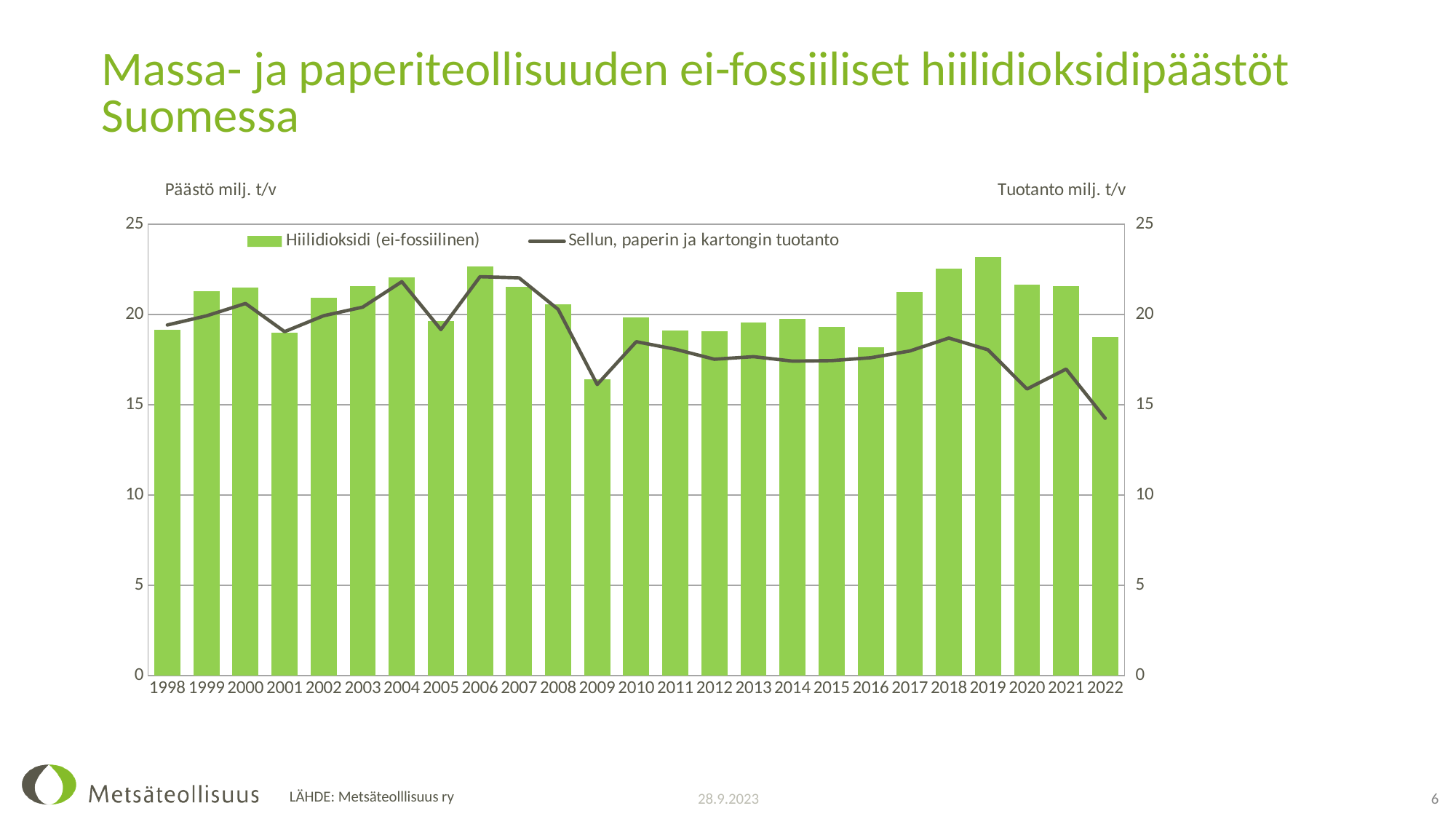
In which year does the Sellun, paperin ja kartongin tuotanto line reach its lowest point? 2022 What kind of chart is shown on the slide? Combined bar and line chart Is the Sellun, paperin ja kartongin tuotanto value for 2022 greater or less than 15? less Does the Sellun, paperin ja kartongin tuotanto line rise or fall from 2019 to 2022? fall Is the Hiilidioksidi (ei-fossiilinen) bar for 2006 taller or shorter than the bar for 2009? taller Is the Hiilidioksidi (ei-fossiilinen) value for 2019 greater or less than 20? greater How many series does the chart legend list? 2 Which year has the tallest bar for Hiilidioksidi (ei-fossiilinen)? 2019 Is the Hiilidioksidi (ei-fossiilinen) value for 2001 greater or less than 20? less Which year has the shortest bar for Hiilidioksidi (ei-fossiilinen)? 2009 How many years are shown on the x axis of the chart? 25